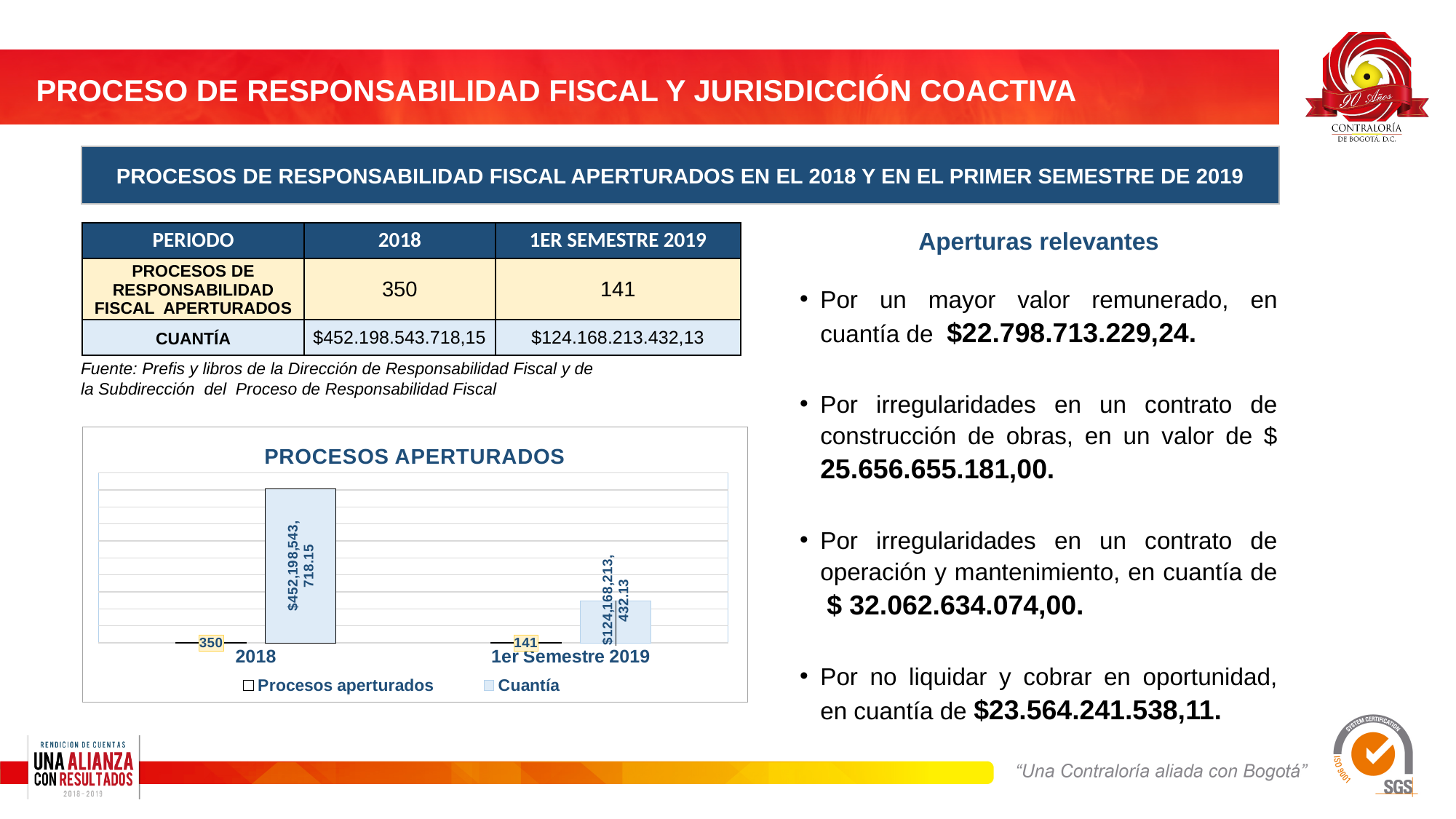
What is the title of the chart on the slide? PROCESOS APERTURADOS In the PROCESOS APERTURADOS chart, which period has the lower number of Procesos aperturados? 1er Semestre 2019 What type of chart is shown under the title PROCESOS APERTURADOS? Bar chart In the PROCESOS APERTURADOS chart, what is the Cuantía value for 1er Semestre 2019? $124,168,213,432.13 In the PROCESOS APERTURADOS chart, what is the difference in Procesos aperturados between 2018 and 1er Semestre 2019? 209 How many series does the legend of the PROCESOS APERTURADOS chart list? 2 In the PROCESOS APERTURADOS chart, do the Cuantía values rise or fall from 2018 to 1er Semestre 2019? Fall In the PROCESOS APERTURADOS chart, what is the value of Procesos aperturados for 2018? 350 In the PROCESOS APERTURADOS chart, what is the Cuantía value for 2018? $452,198,543,718.15 How many categories are shown on the x axis of the PROCESOS APERTURADOS chart? 2 In the PROCESOS APERTURADOS chart, which period has the higher Cuantía? 2018 In the PROCESOS APERTURADOS chart, what is the value of Procesos aperturados for 1er Semestre 2019? 141